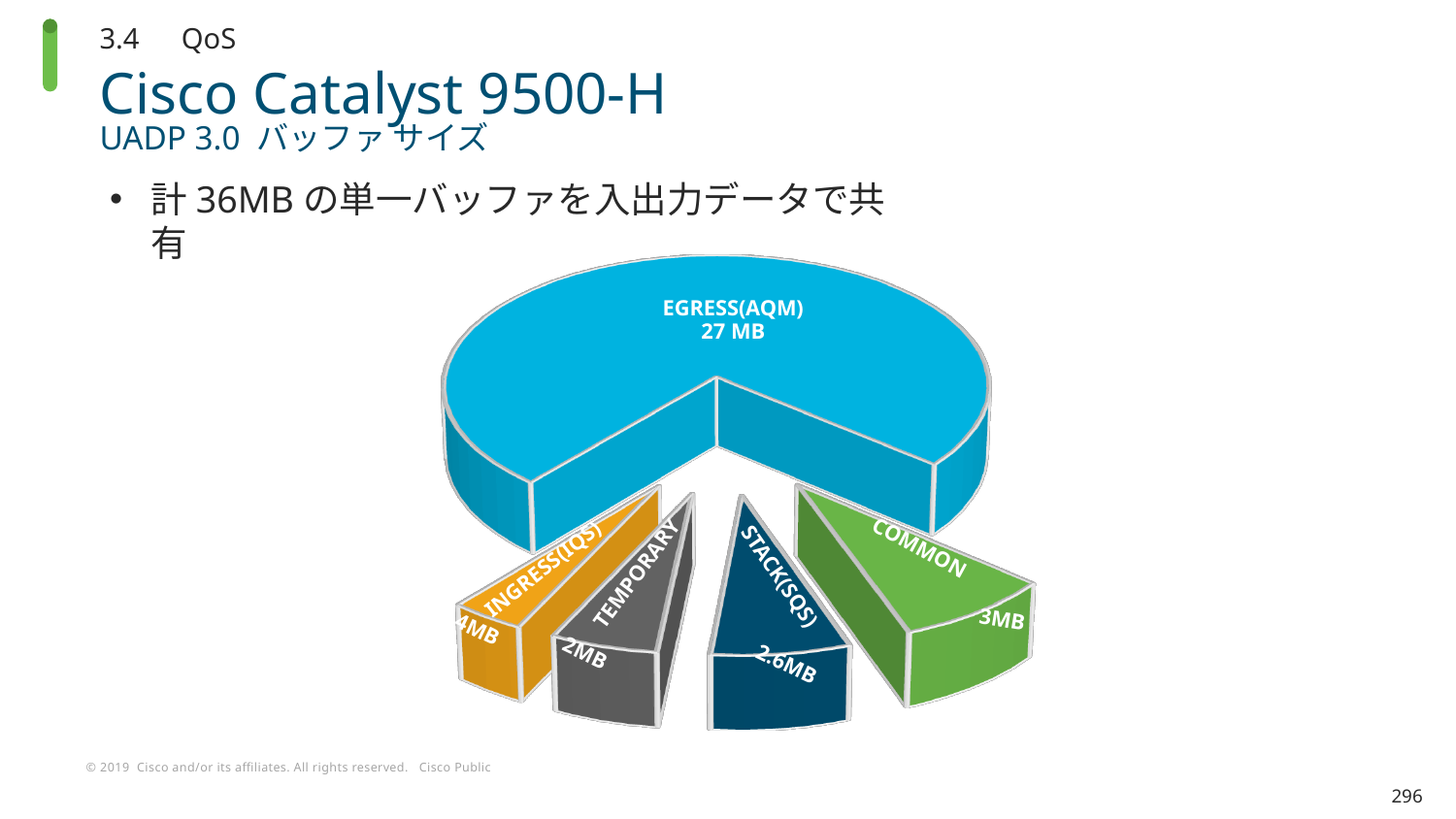
What is the difference between the STACK(SQS) value and the TEMPORARY value? 0.6MB How much larger is the EGRESS(AQM) slice than the COMMON slice? 24 MB What kind of chart is shown on the slide? pie chart What colour is the EGRESS(AQM) slice? blue Which is larger, the COMMON slice or the STACK(SQS) slice? COMMON Which slice of the pie chart is the smallest? INGRESS(IQS) What is the value shown for the COMMON slice? 3MB Which slice of the pie chart is the largest? EGRESS(AQM) What is the value shown for the TEMPORARY slice? 2MB What is the value shown for the EGRESS(AQM) slice? 27 MB What is the value shown for the STACK(SQS) slice? 2.6MB How many slices does the pie chart have? 5